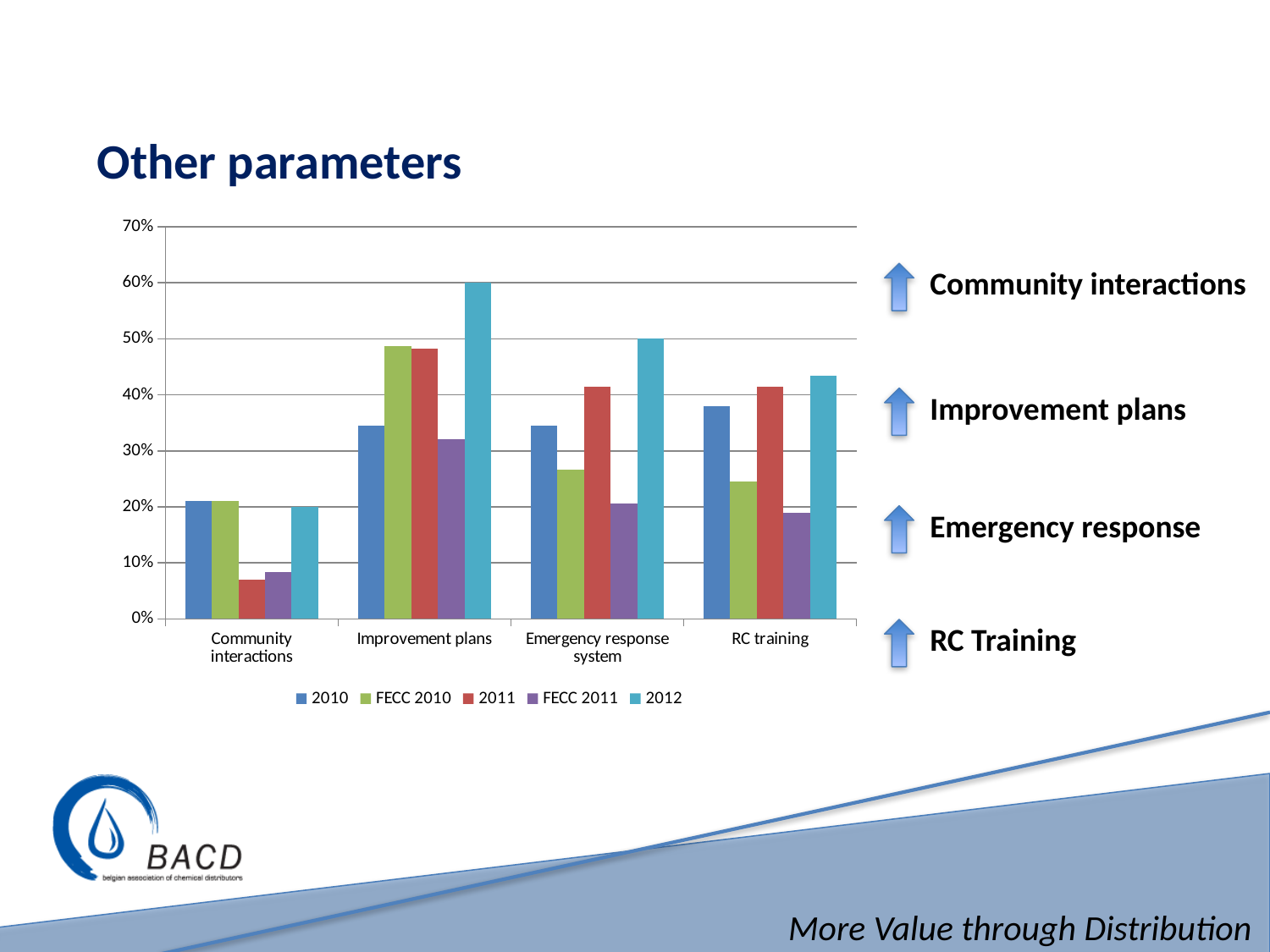
What is the 2012 value for Community interactions? 20% What kind of chart is shown on the slide? bar chart Is the 2011 value for Community interactions greater or less than 10%? less For Emergency response system, which is larger: the 2011 value or the FECC 2011 value? 2011 Which category has the highest 2012 value? Improvement plans How many categories are shown on the x axis of the chart? 4 What is the 2012 value for Improvement plans? 60% Which series is shown in light blue in the chart legend? 2012 Which category has the lowest 2011 value? Community interactions How many series does the chart legend list? 5 What is the 2012 value for Emergency response system? 50% Is the 2010 value for RC training greater or less than 30%? greater